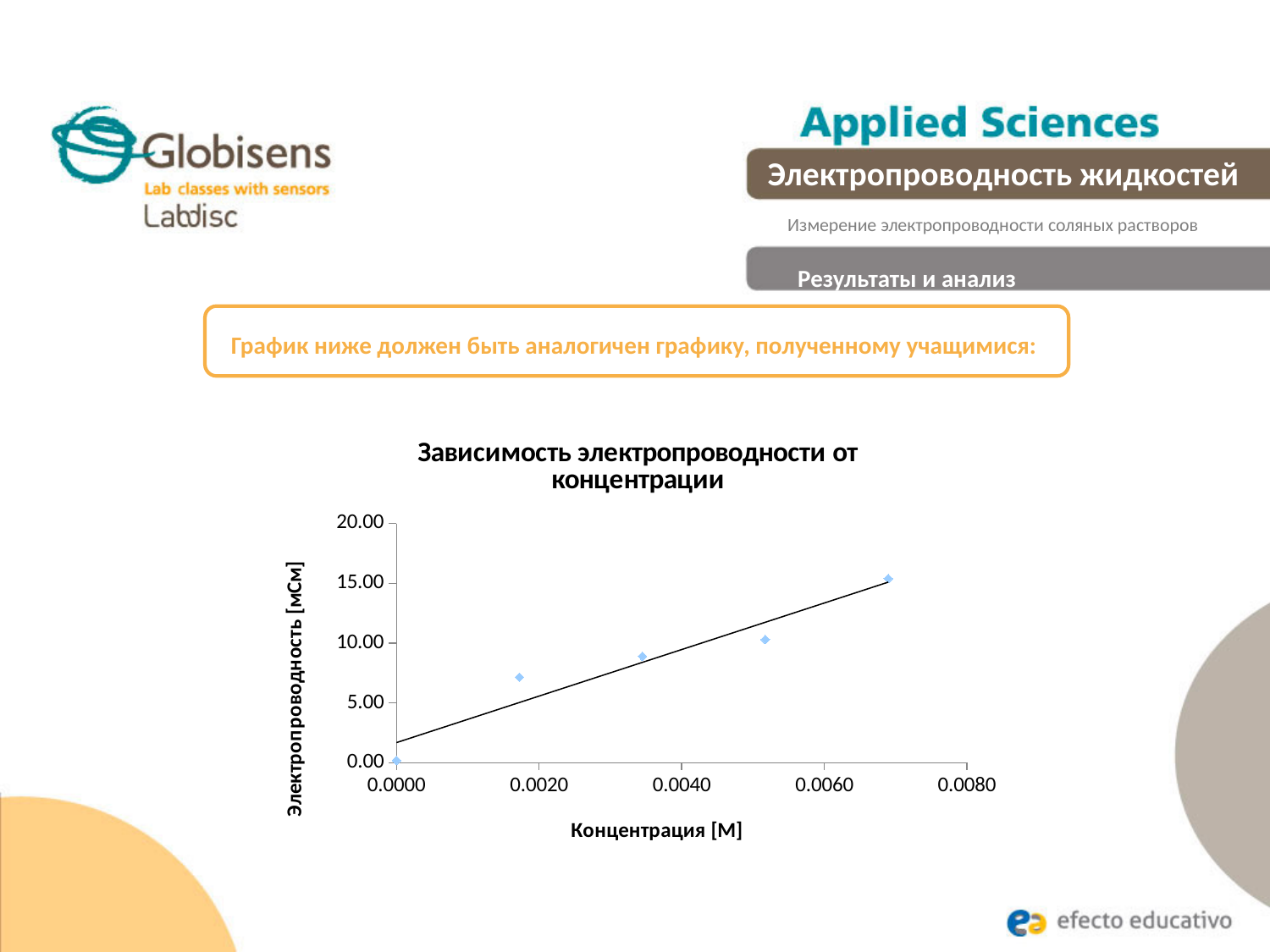
Do the plotted values rise or fall as concentration increases along the x axis? rise Is the conductivity value for the point at roughly 0.0017 M greater or less than 10.00? less Is the conductivity value for the point at roughly 0.0052 M greater or less than 15.00? less What kind of chart is shown on the slide? scatter chart Is the conductivity value for the point at roughly 0.0035 M greater or less than 5.00? greater At which concentration is the lowest conductivity value plotted? 0.0000 Which plotted point has the highest conductivity: the one at roughly 0.0052 M or the one at roughly 0.0070 M? the one at roughly 0.0070 M How many data points are plotted on the chart? 5 What is the title of the chart? Зависимость электропроводности от концентрации What is the label of the x axis? Концентрация [M]